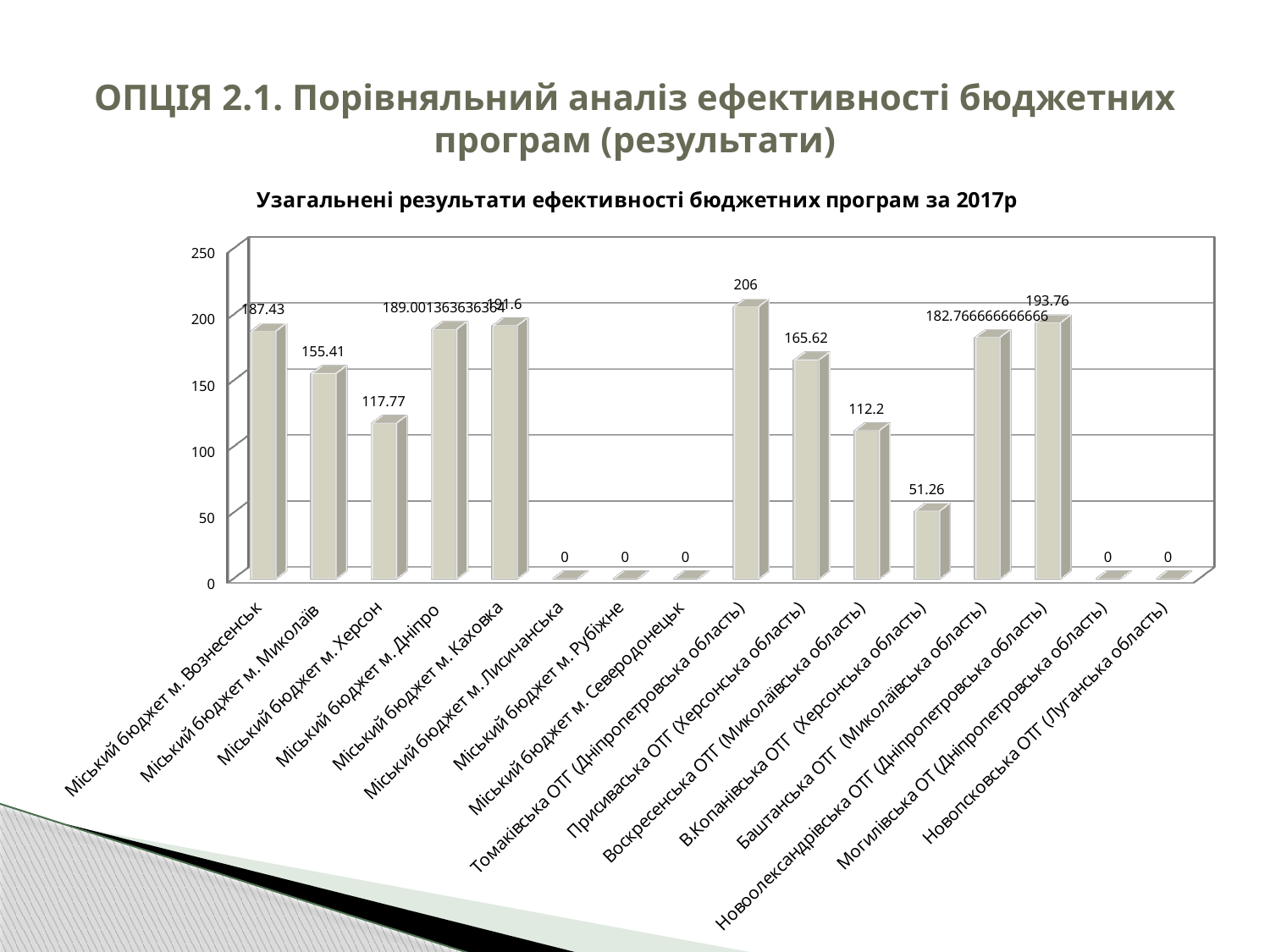
What is the difference between the values for Міський бюджет м. Вознесенськ and Міський бюджет м. Миколаїв? 32.02 What is the difference between the values for Томаківська ОТГ (Дніпропетровська область) and Новоолександрівська ОТГ (Дніпропетровська область)? 12.24 What is the value for Міський бюджет м. Каховка? 191.6 Which is larger, the value for Міський бюджет м. Херсон or the value for Воскресенська ОТГ (Миколаївська область)? Міський бюджет м. Херсон What is the value for Міський бюджет м. Вознесенськ? 187.43 What kind of chart is this? Bar chart Which category has the highest value? Томаківська ОТГ (Дніпропетровська область) How many categories are shown on the x axis? 16 How many categories have a value of 0? 5 What is the value for В.Копанівська ОТГ (Херсонська область)? 51.26 What is the value for Присиваська ОТГ (Херсонська область)? 165.62 Which category has the lowest non-zero value? В.Копанівська ОТГ (Херсонська область)